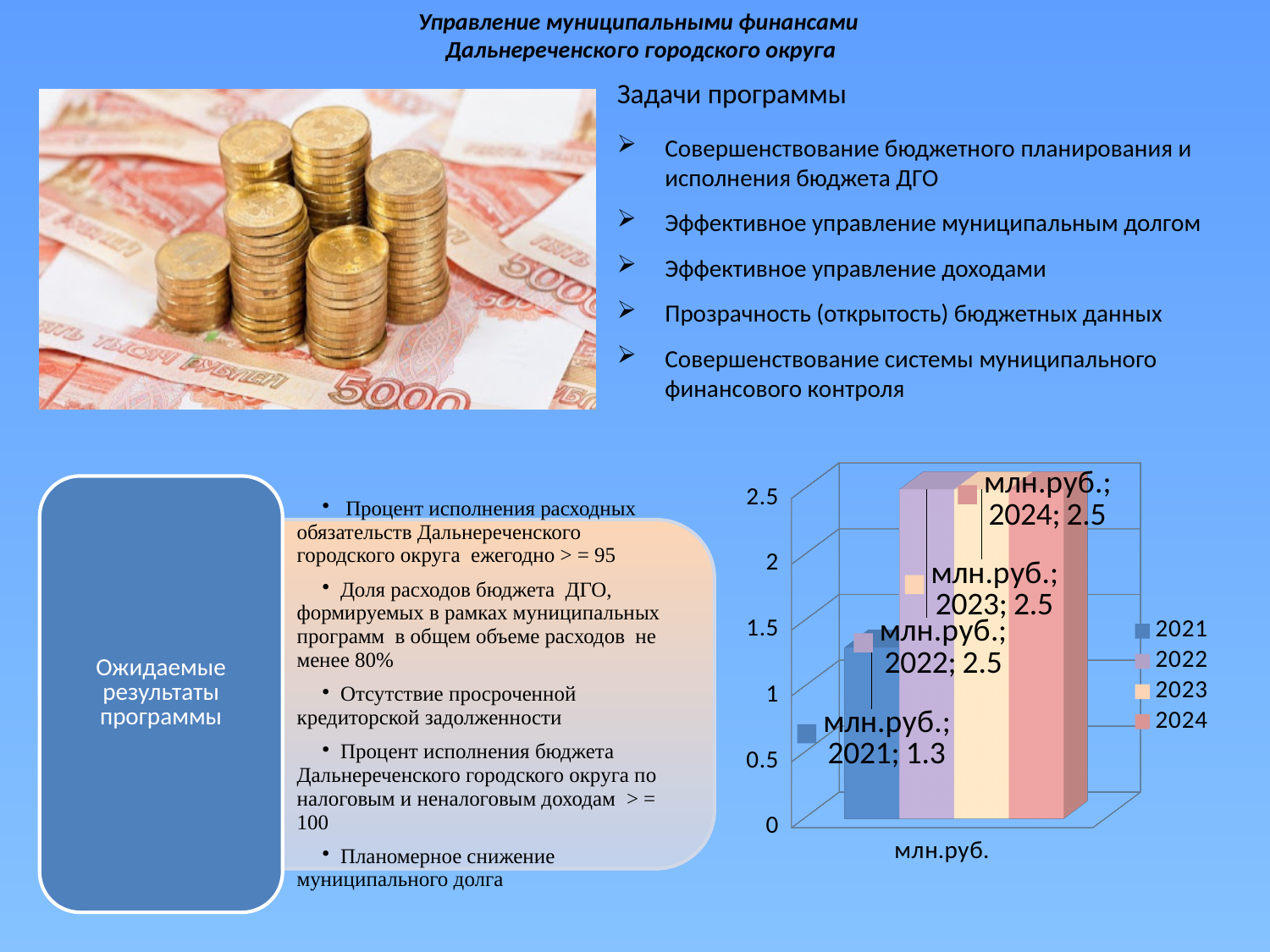
Which is larger, the value for 2021 or the value for 2024? 2024 What is the value for 2023 on the chart? 2.5 What is the value for 2021 on the chart? 1.3 What is the category label shown under the bars on the x axis? млн.руб. Which year has the lowest value on the chart? 2021 What kind of chart is shown on the slide? bar chart What is the value for 2024 on the chart? 2.5 What is the highest value shown on the vertical axis of the chart? 2.5 What is the value for 2022 on the chart? 2.5 How many series does the legend list? 4 Is the value for 2021 greater or less than 1.5? less What is the difference between the values for 2022 and 2021? 1.2